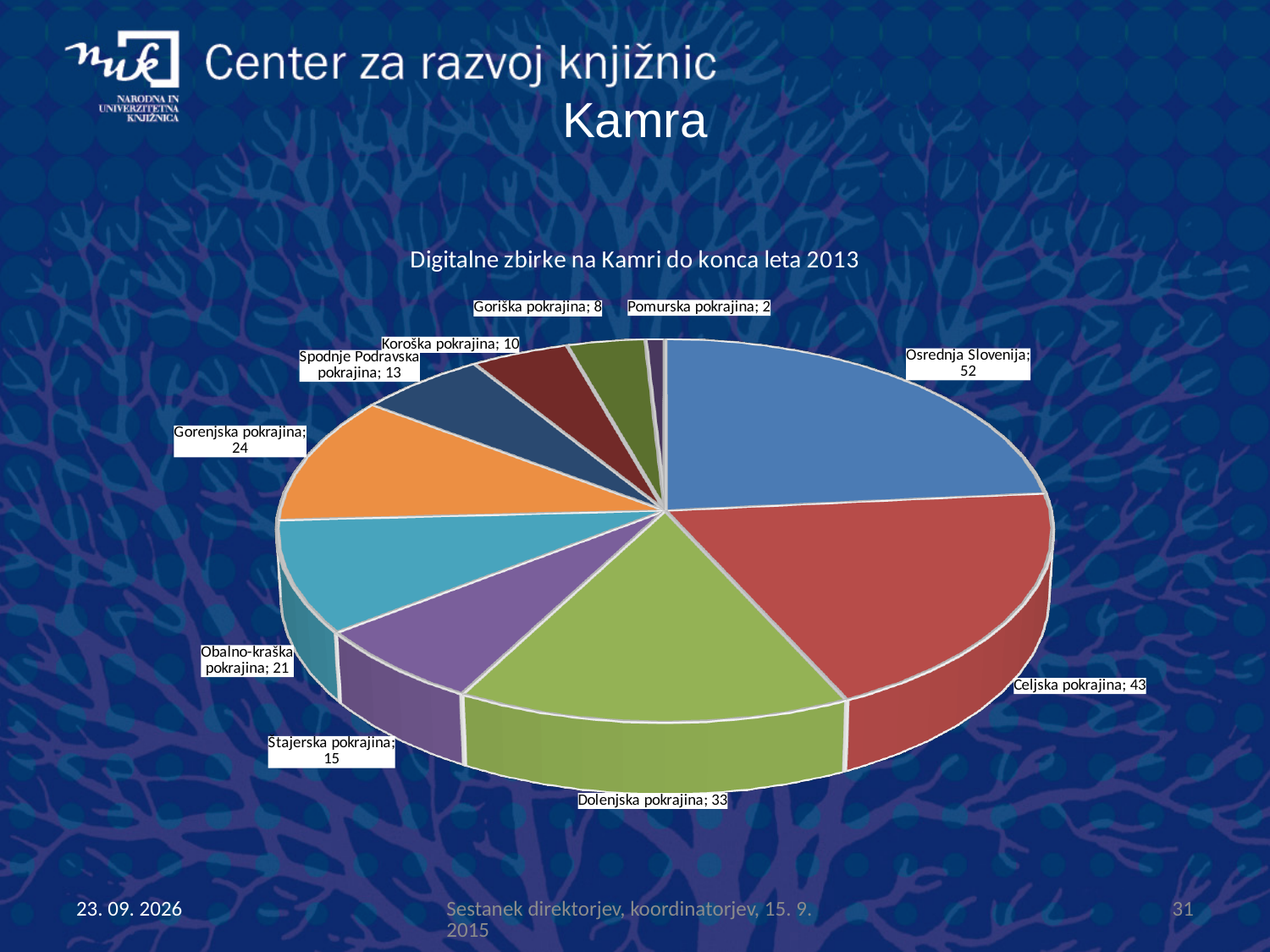
Which region has the smallest slice? Pomurska pokrajina What is the title of the chart? Digitalne zbirke na Kamri do konca leta 2013 What is the difference between the values for Osrednja Slovenija and Celjska pokrajina? 9 What is the total of all the values shown in the pie chart? 221 Which region has the largest slice? Osrednja Slovenija Which is larger, the value for Štajerska pokrajina or the value for Koroška pokrajina? Štajerska pokrajina What is the difference between the values for Gorenjska pokrajina and Obalno-kraška pokrajina? 3 What kind of chart is shown on the slide? pie chart How many slices does the pie chart have? 10 What is the value for Dolenjska pokrajina? 33 What is the value for Spodnje Podravska pokrajina? 13 What is the value for Osrednja Slovenija? 52